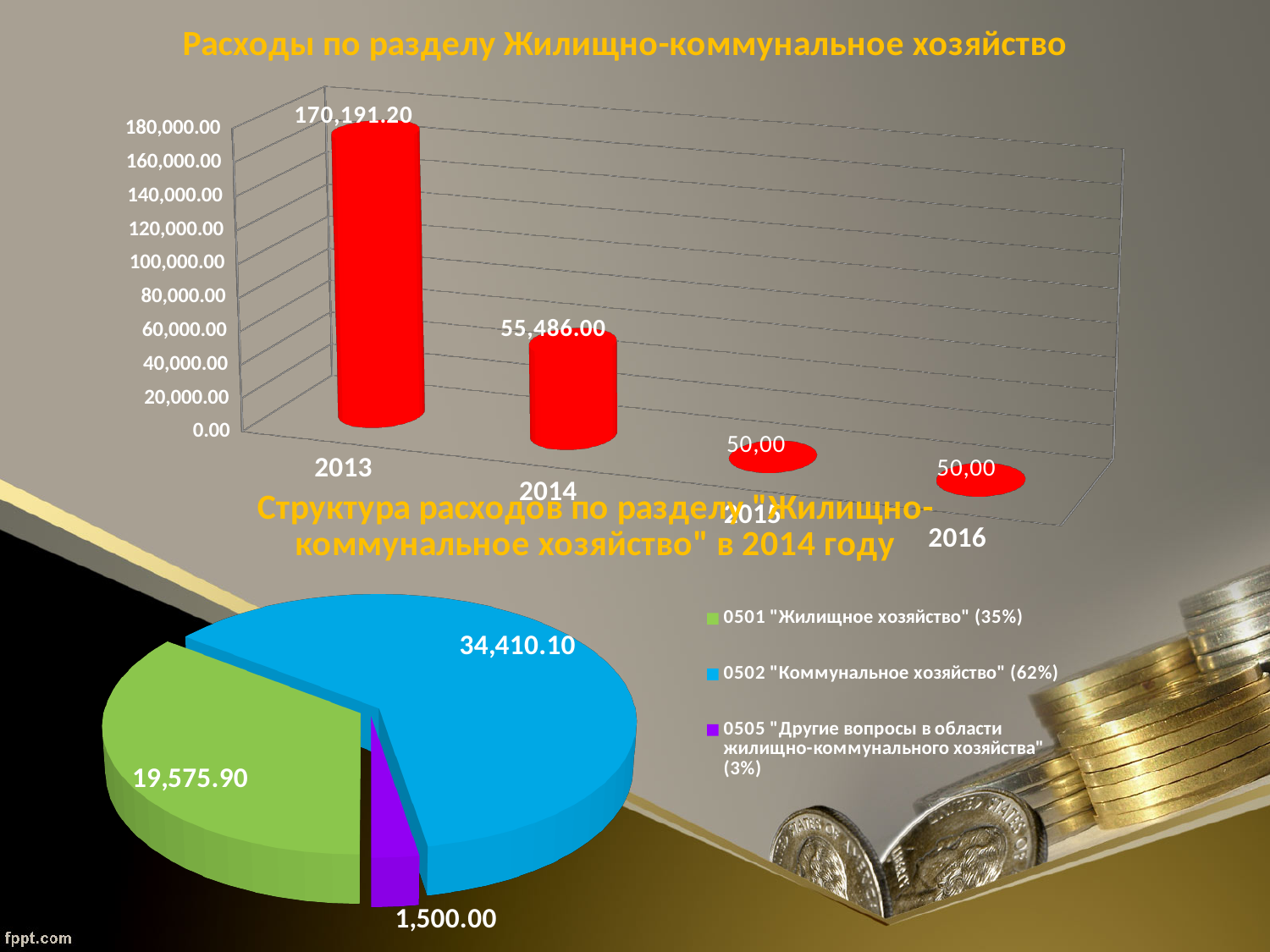
In the pie chart "Структура расходов по разделу "Жилищно-коммунальное хозяйство" в 2014 году", what is the value for 0502 "Коммунальное хозяйство"? 34,410.10 What kind of chart is the top chart "Расходы по разделу Жилищно-коммунальное хозяйство"? bar chart In the bar chart "Расходы по разделу Жилищно-коммунальное хозяйство", do the values rise or fall from 2013 to 2016? fall In the pie chart "Структура расходов по разделу "Жилищно-коммунальное хозяйство" в 2014 году", which slice is the smallest? 0505 "Другие вопросы в области жилищно-коммунального хозяйства" In the bar chart "Расходы по разделу Жилищно-коммунальное хозяйство", what is the difference between the 2013 and 2014 values? 114,705.20 In the bar chart "Расходы по разделу Жилищно-коммунальное хозяйство", how many years are shown on the x axis? 4 In the pie chart "Структура расходов по разделу "Жилищно-коммунальное хозяйство" в 2014 году", what share does 0501 "Жилищное хозяйство" have? 35% In the bar chart "Расходы по разделу Жилищно-коммунальное хозяйство", what is the value for 2014? 55,486.00 In the bar chart "Расходы по разделу Жилищно-коммунальное хозяйство", which year has the highest value? 2013 In the bar chart "Расходы по разделу Жилищно-коммунальное хозяйство", what is the value for 2013? 170,191.20 In the pie chart "Структура расходов по разделу "Жилищно-коммунальное хозяйство" в 2014 году", what is the value for 0505 "Другие вопросы в области жилищно-коммунального хозяйства"? 1,500.00 In the pie chart "Структура расходов по разделу "Жилищно-коммунальное хозяйство" в 2014 году", how many entries does the legend list? 3